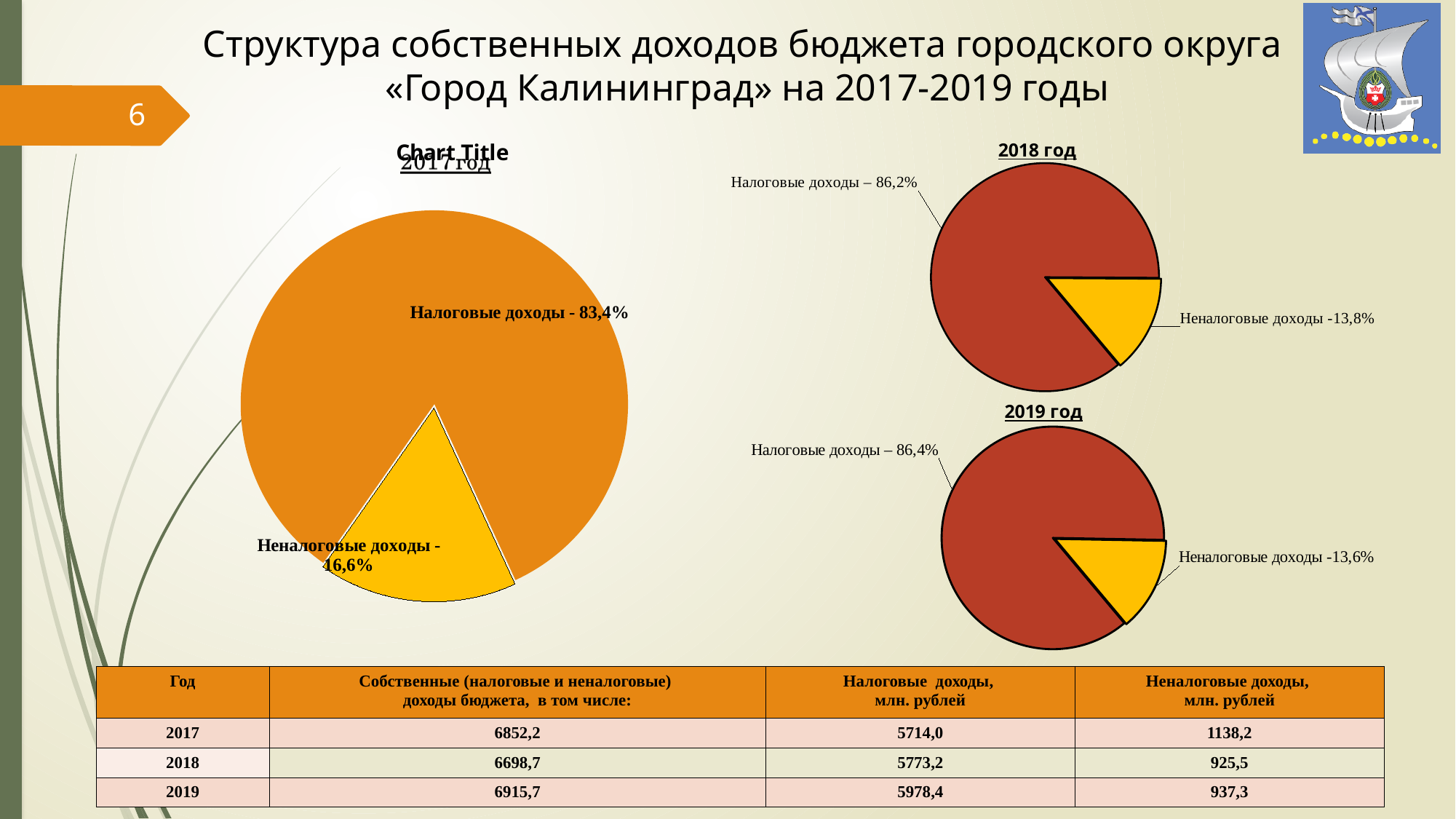
Which is larger: the Неналоговые доходы share in the 2018 год chart or in the 2019 год chart? 2018 год What type of chart is used to show the 2017 budget structure? Pie chart In the 2017 pie chart, what share is shown for Налоговые доходы? 83,4% How many slices does the 2018 год pie chart have? 2 In the 2017 pie chart, which slice is the smallest? Неналоговые доходы In the 2018 год pie chart, what share is shown for Налоговые доходы? 86,2% In the 2017 pie chart, what is the difference between the Налоговые доходы share and the Неналоговые доходы share? 66,8% In the 2019 год pie chart, which slice is the largest? Налоговые доходы In the 2019 год pie chart, what share is shown for Неналоговые доходы? 13,6% In the 2019 год pie chart, what share is shown for Налоговые доходы? 86,4% In the 2018 год pie chart, what share is shown for Неналоговые доходы? 13,8% In the 2017 pie chart, what share is shown for Неналоговые доходы? 16,6%